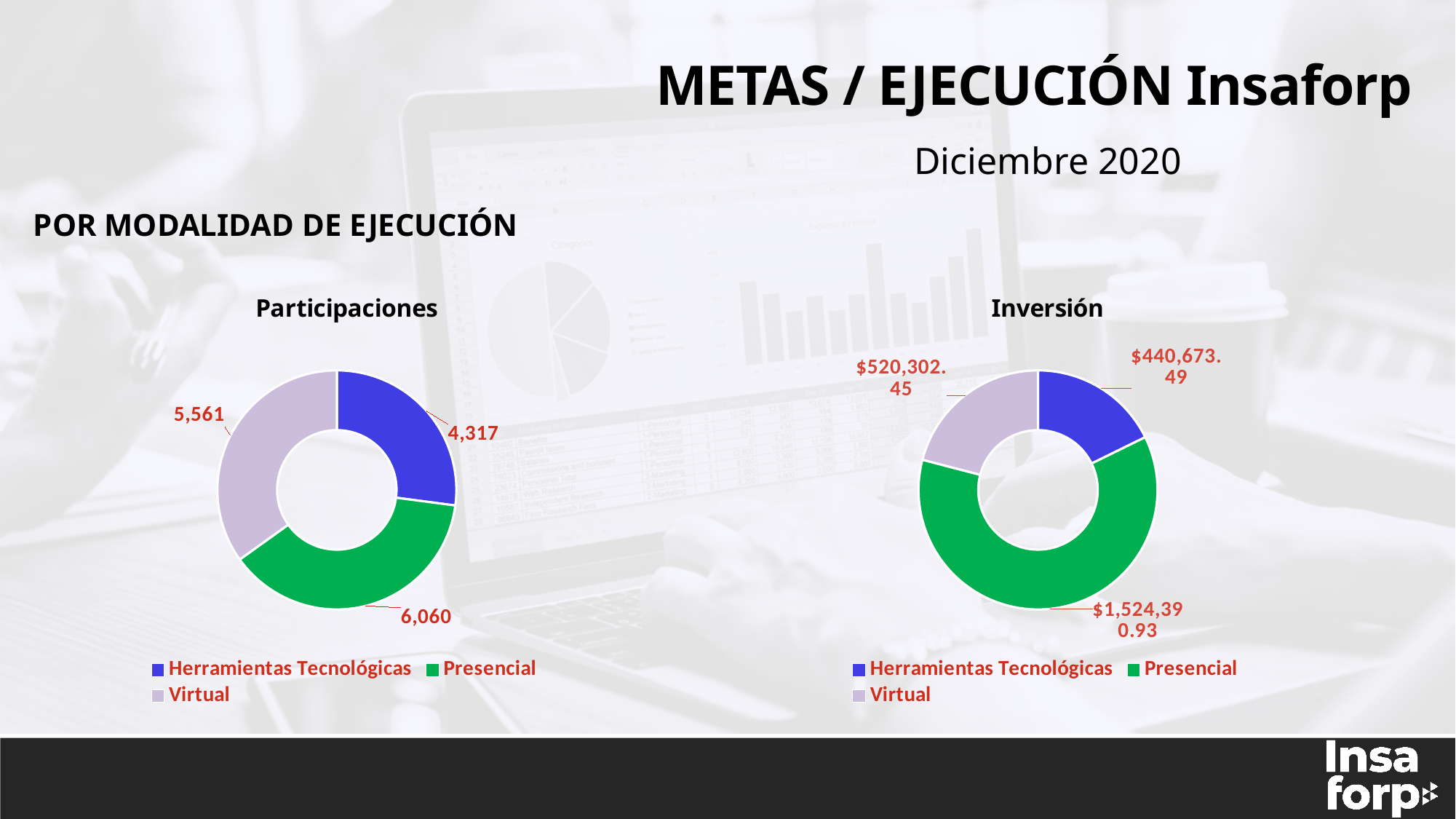
How many categories does the Participaciones chart show? 3 In the Inversión chart, what is the value for Virtual? $520,302.45 In the Inversión chart, which modality has the lowest investment? Herramientas Tecnológicas In the Inversión chart, which colour represents Presencial? Green In the Participaciones chart, what is the difference between Virtual and Herramientas Tecnológicas? 1,244 What type of chart is the Inversión chart? Doughnut chart In the Participaciones chart, which modality has the highest number of participations? Presencial In the Participaciones chart, what is the value for Herramientas Tecnológicas? 4,317 In the Participaciones chart, what is the difference between Presencial and Virtual? 499 In the Inversión chart, what is the value for Presencial? $1,524,390.93 In the Participaciones chart, what is the value for Presencial? 6,060 In the Inversión chart, which is larger: Virtual or Herramientas Tecnológicas? Virtual